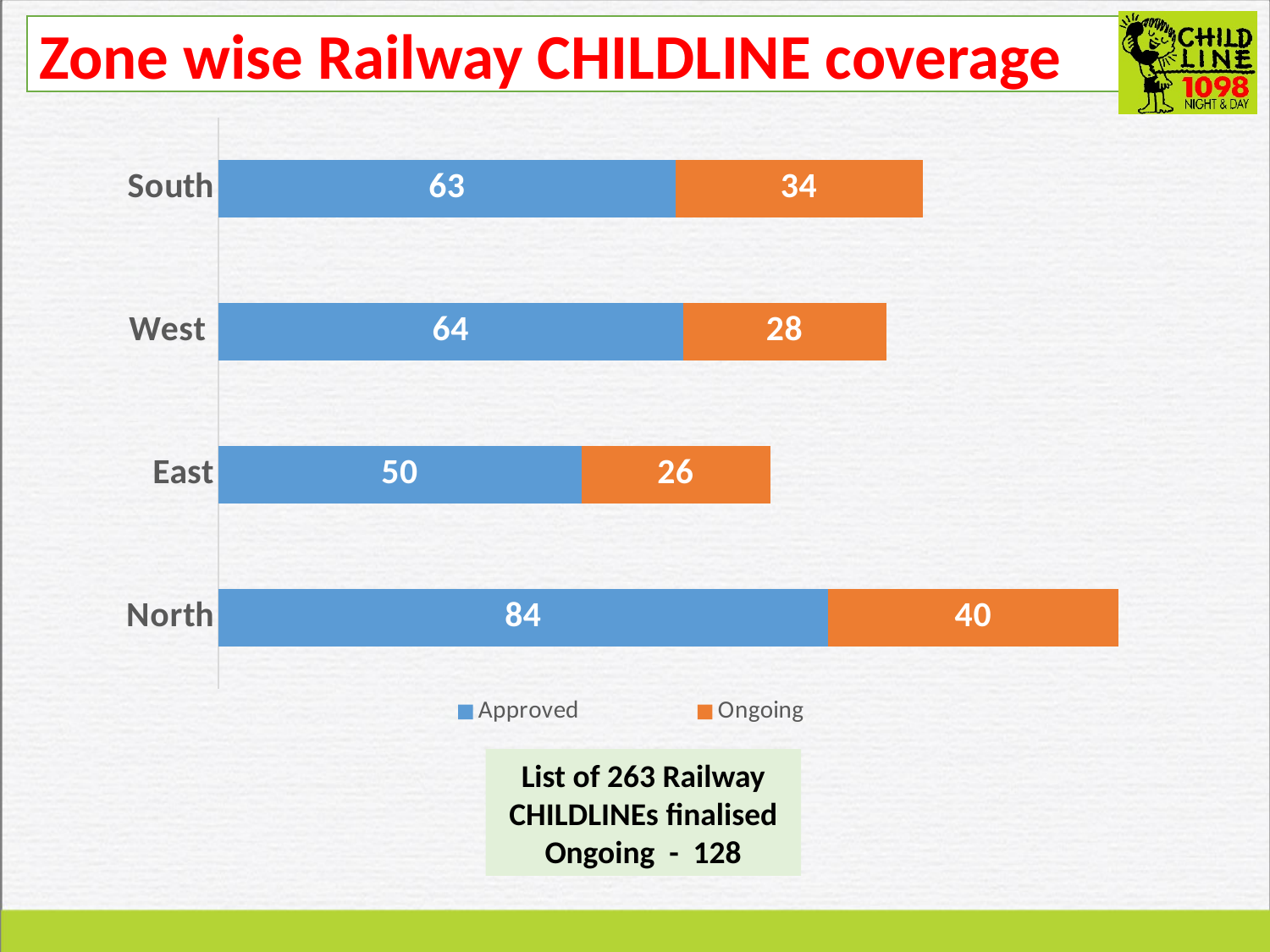
What is the difference between the Approved values for North and East? 34 What is the title of the chart? Zone wise Railway CHILDLINE coverage How many zones are shown in the chart? 4 What is the Ongoing value for South? 34 Which is larger, the Ongoing value for West or the Ongoing value for South? South How many series does the legend list? 2 Which zone has the highest Approved value? North Which zone has the lowest Ongoing value? East What is the total of the stacked bar for North? 124 What is the Approved value for North? 84 What is the Approved value for East? 50 What kind of chart is shown on the slide? Bar chart